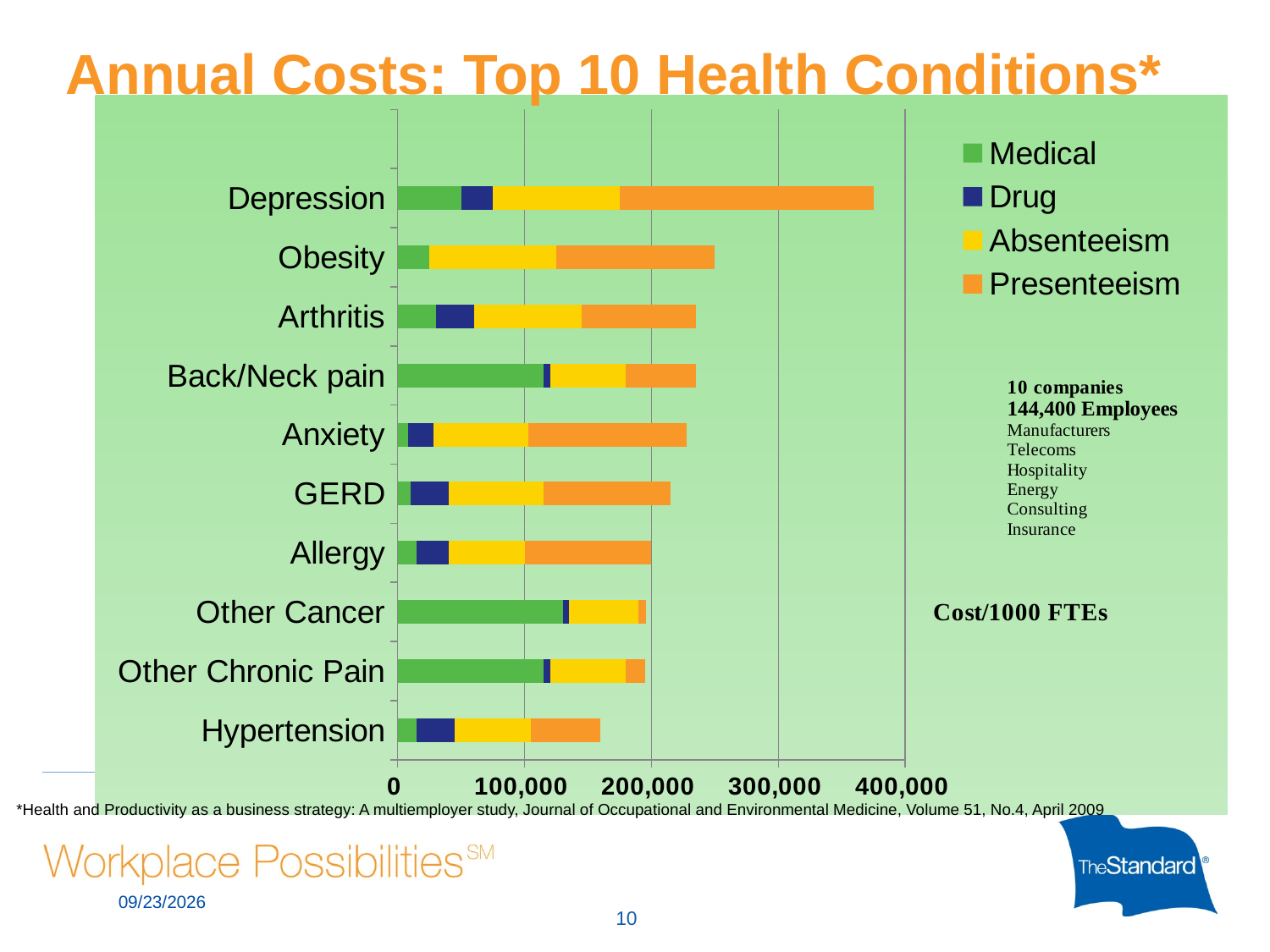
Is the Medical cost for Back/Neck pain greater or less than 100,000? greater What is the title of the chart? Annual Costs: Top 10 Health Conditions* What kind of chart is shown on the slide? Stacked bar chart Which has a larger total cost, Depression or Obesity? Depression Which health condition has the highest total annual cost? Depression How many health conditions are listed on the chart? 10 Which colour represents Presenteeism in the chart? Orange Is the total cost for Obesity greater or less than 200,000? greater Is the total cost for Depression greater or less than 300,000? greater Which health condition has the lowest total annual cost? Hypertension How many series does the legend list? 4